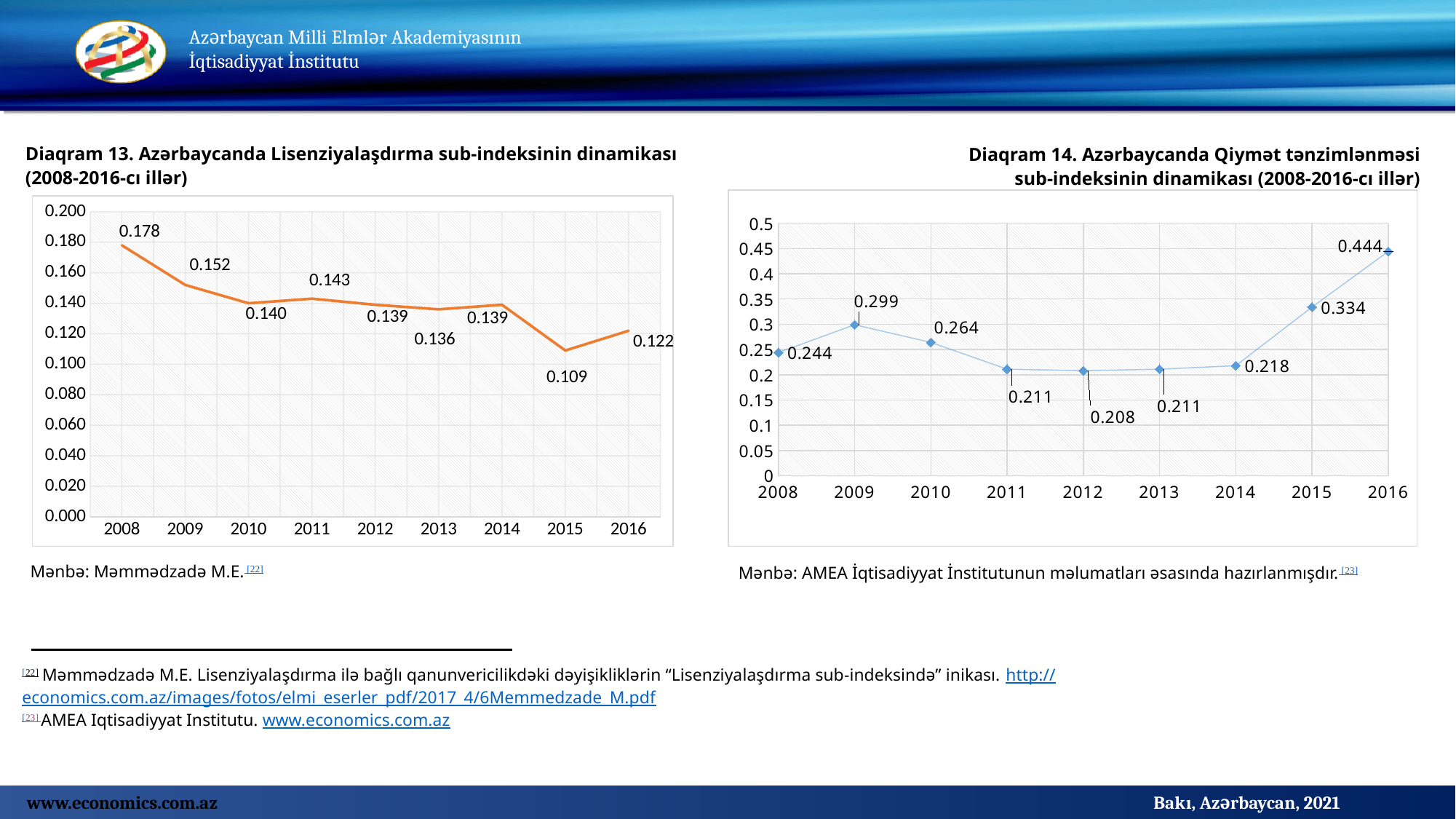
In Diaqram 13 (left chart), what is the difference between the 2008 value and the 2016 value? 0.056 What kind of chart is Diaqram 13 (left chart)? Line chart In Diaqram 13 (left chart), what is the value for 2015? 0.109 In Diaqram 14 (right chart), which is larger, the value for 2009 or the value for 2015? 2015 In Diaqram 13 (left chart), what is the value for 2008? 0.178 In Diaqram 14 (right chart), do the values rise or fall from 2014 to 2016? Rise In Diaqram 14 (right chart), what is the difference between the 2016 value and the 2015 value? 0.110 In Diaqram 14 (right chart), which year has the highest value? 2016 In Diaqram 14 (right chart), what is the value for 2012? 0.208 In Diaqram 13 (left chart), which year has the lowest value? 2015 In Diaqram 13 (left chart), how many years are plotted? 9 In Diaqram 14 (right chart), what is the value for 2016? 0.444